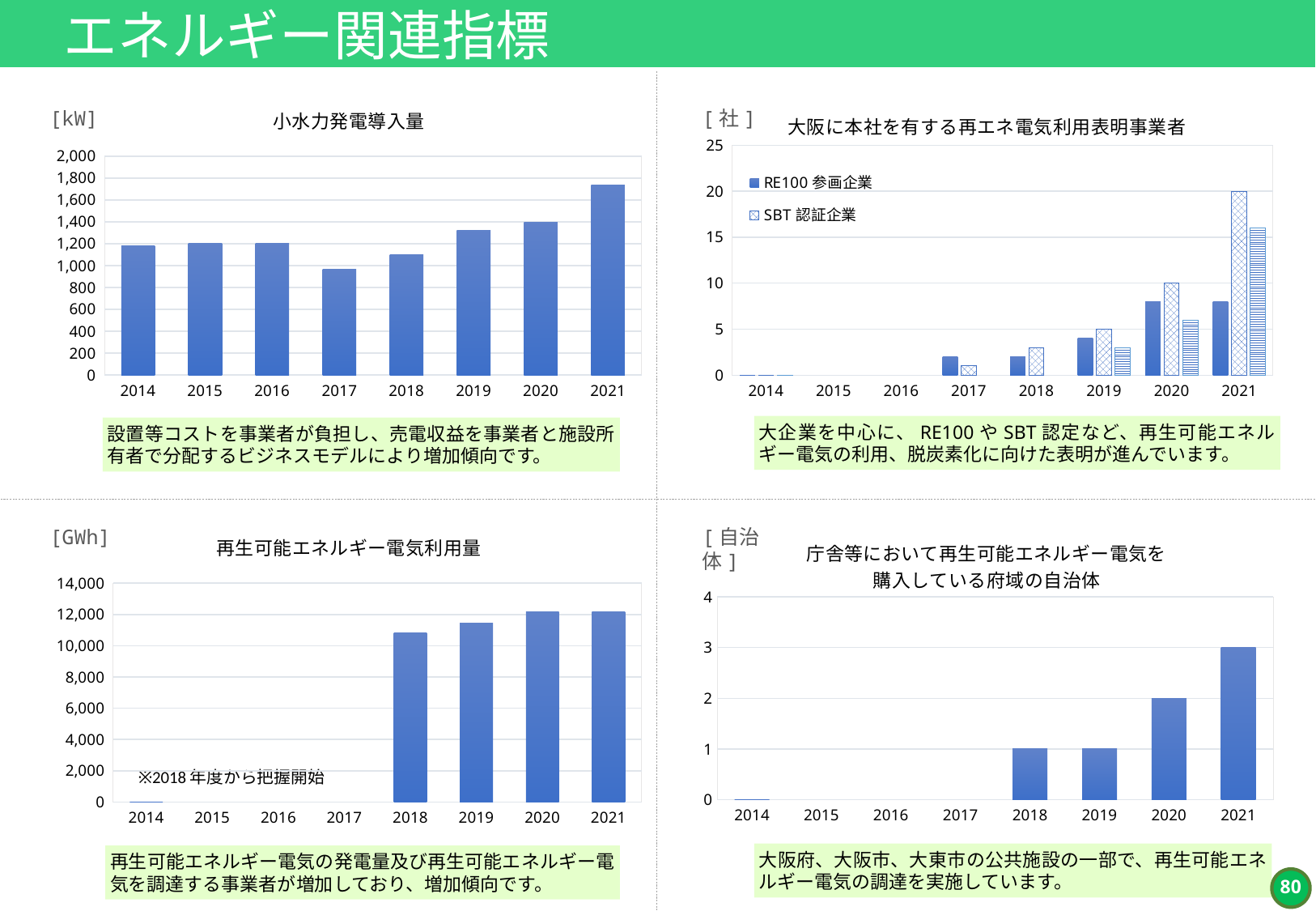
In the 大阪に本社を有する再エネ電気利用表明事業者 chart, what is the value for SBT 認証企業 in 2021? 20 In the 小水力発電導入量 chart, is the value for 2017 greater or less than 1,000? less In the 再生可能エネルギー電気利用量 chart, is the value for 2018 greater or less than 10,000? greater In the 再生可能エネルギー電気利用量 chart, is the value for 2019 greater or less than 12,000? less In the 小水力発電導入量 chart, which year has the lowest value? 2017 In the 庁舎等において再生可能エネルギー電気を購入している府域の自治体 chart, what is the value for 2021? 3 What kind of chart is the 小水力発電導入量 chart at the top left? bar chart In the 庁舎等において再生可能エネルギー電気を購入している府域の自治体 chart, what is the difference between the values for 2021 and 2018? 2 In the 大阪に本社を有する再エネ電気利用表明事業者 chart, which is larger in 2021, RE100 参画企業 or SBT 認証企業? SBT 認証企業 In the 小水力発電導入量 chart, which year has the highest value? 2021 How many series does the legend list in the 大阪に本社を有する再エネ電気利用表明事業者 chart? 2